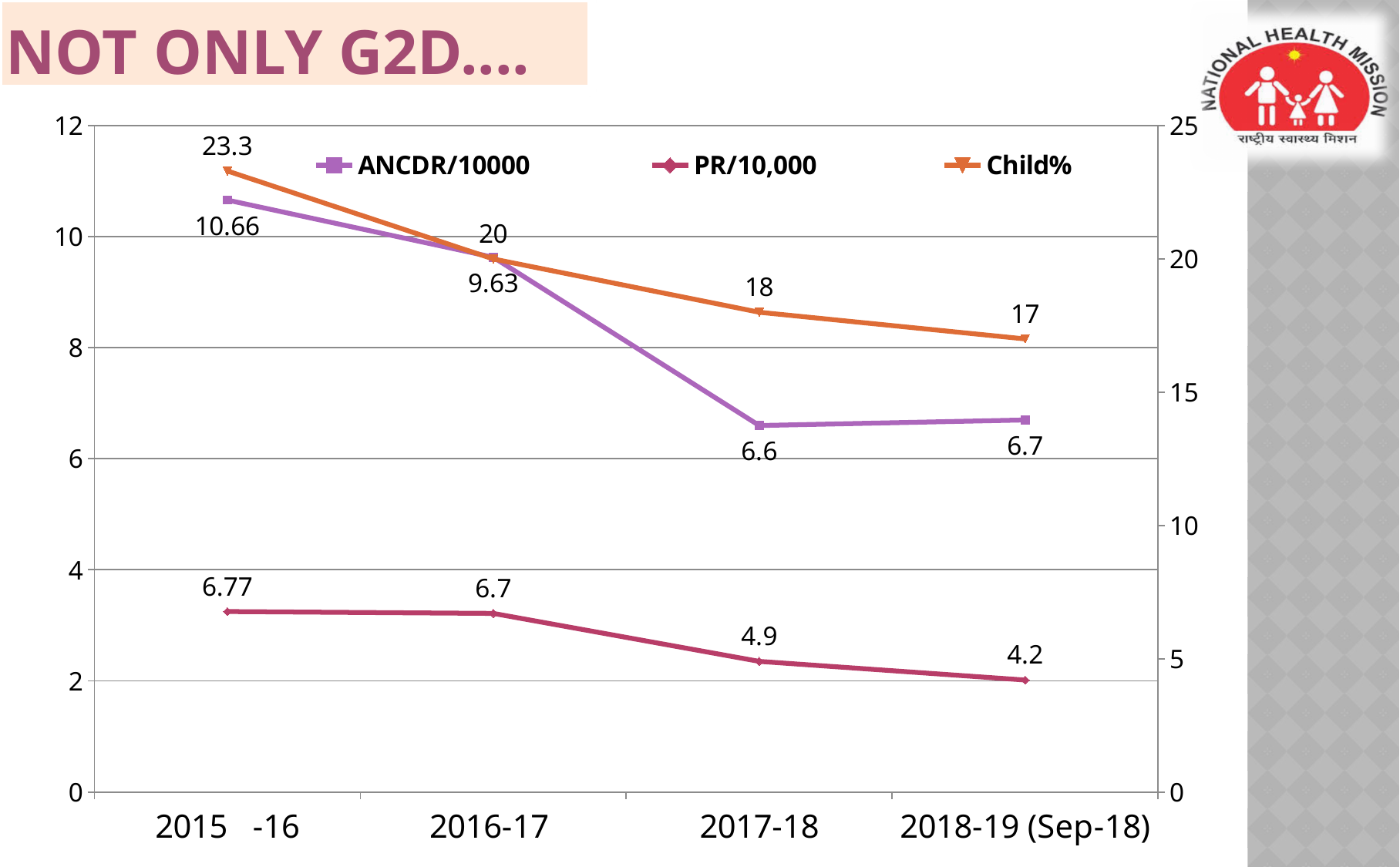
Does the Child% series rise or fall from 2015-16 to 2018-19 (Sep-18)? fall How many series does the legend list? 3 In which period is the ANCDR/10000 value lowest? 2017-18 How many time periods are shown on the x axis? 4 What is the difference between the Child% values for 2015-16 and 2018-19 (Sep-18)? 6.3 Which is larger, the PR/10,000 value for 2017-18 or for 2018-19 (Sep-18)? 2017-18 What is the ANCDR/10000 value for 2015-16? 10.66 In which period is the Child% value highest? 2015-16 What type of chart is shown on the slide? line chart What is the PR/10,000 value for 2018-19 (Sep-18)? 4.2 What is the Child% value for 2016-17? 20 What is the title of the slide? NOT ONLY G2D....